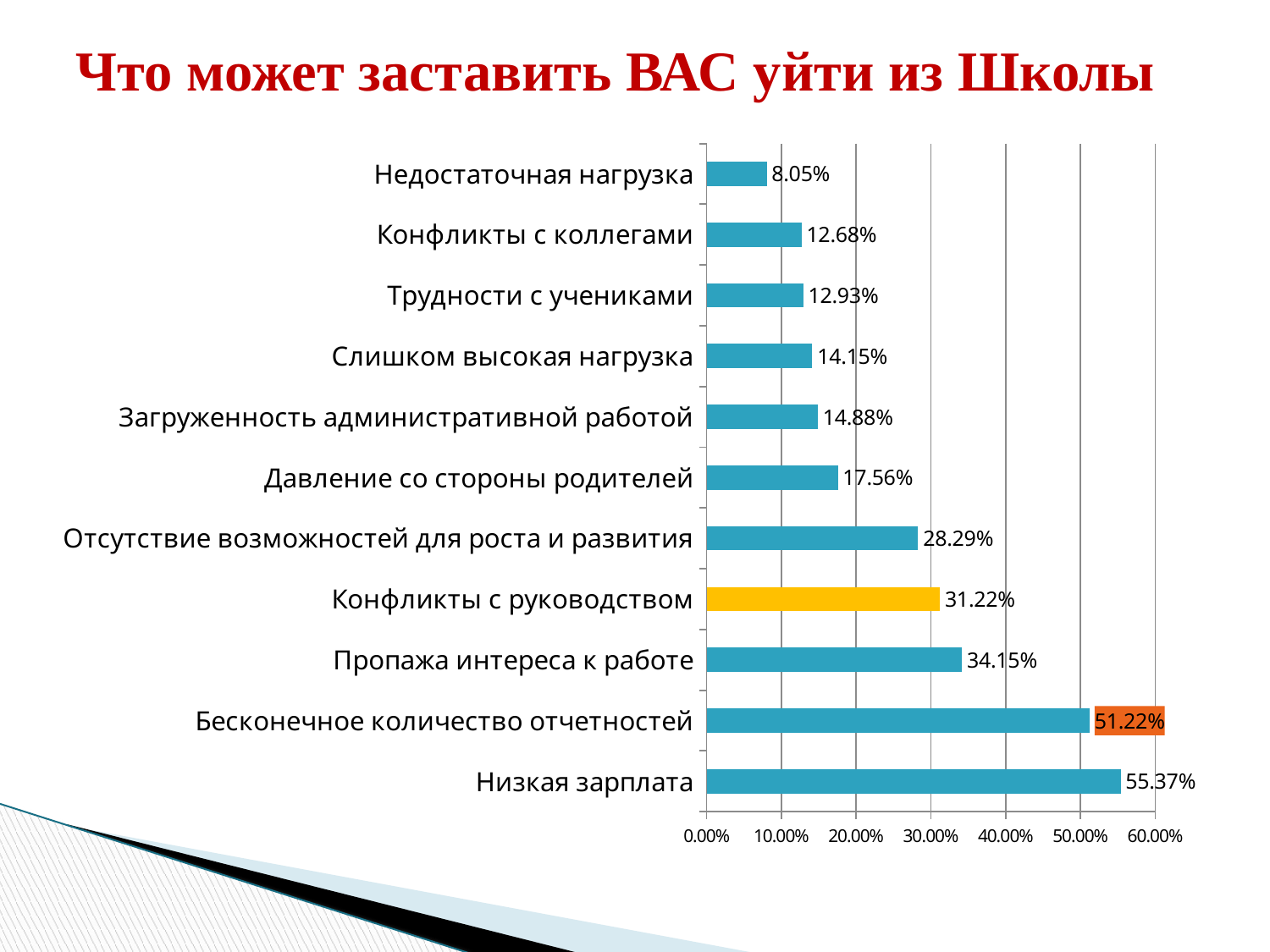
Which category has the lowest value? Недостаточная нагрузка What kind of chart is shown on the slide? bar chart Which category has the highest value? Низкая зарплата What is the value for Конфликты с руководством? 31.22% What is the value for Низкая зарплата? 55.37% Is the value for Давление со стороны родителей greater or less than 20.00%? less What is the difference between the values for Отсутствие возможностей для роста и развития and Давление со стороны родителей? 10.73% What is the title of the slide? Что может заставить ВАС уйти из Школы Which is larger: the value for Пропажа интереса к работе or the value for Конфликты с руководством? Пропажа интереса к работе How many categories are shown in the chart? 11 What is the difference between the values for Низкая зарплата and Бесконечное количество отчетностей? 4.15% What is the value for Загруженность административной работой? 14.88%